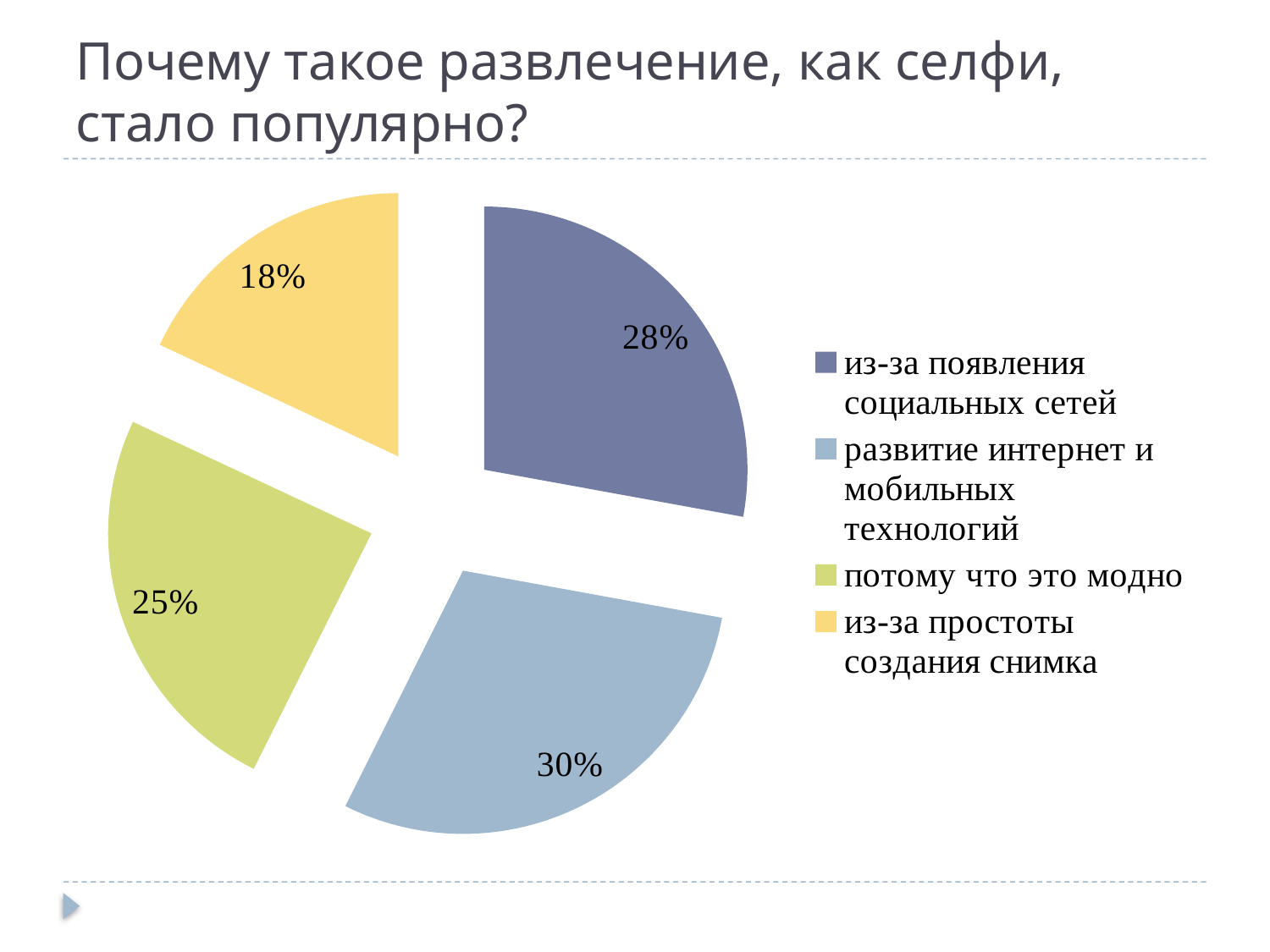
How many slices does the pie chart have? 4 Which is larger: the slice for "из-за появления социальных сетей" or the slice for "потому что это модно"? из-за появления социальных сетей What share of the pie is labelled "из-за появления социальных сетей"? 28% What kind of chart is shown on the slide? pie chart What colour is the slice for "из-за простоты создания снимка"? yellow Which category has the smallest slice of the pie? из-за простоты создания снимка What share of the pie is labelled "из-за простоты создания снимка"? 18% What share of the pie is labelled "потому что это модно"? 25% Which category has the largest slice of the pie? развитие интернет и мобильных технологий What share of the pie is labelled "развитие интернет и мобильных технологий"? 30% What is the title of the slide containing the chart? Почему такое развлечение, как селфи, стало популярно? What is the difference in percentage points between "развитие интернет и мобильных технологий" and "из-за простоты создания снимка"? 12